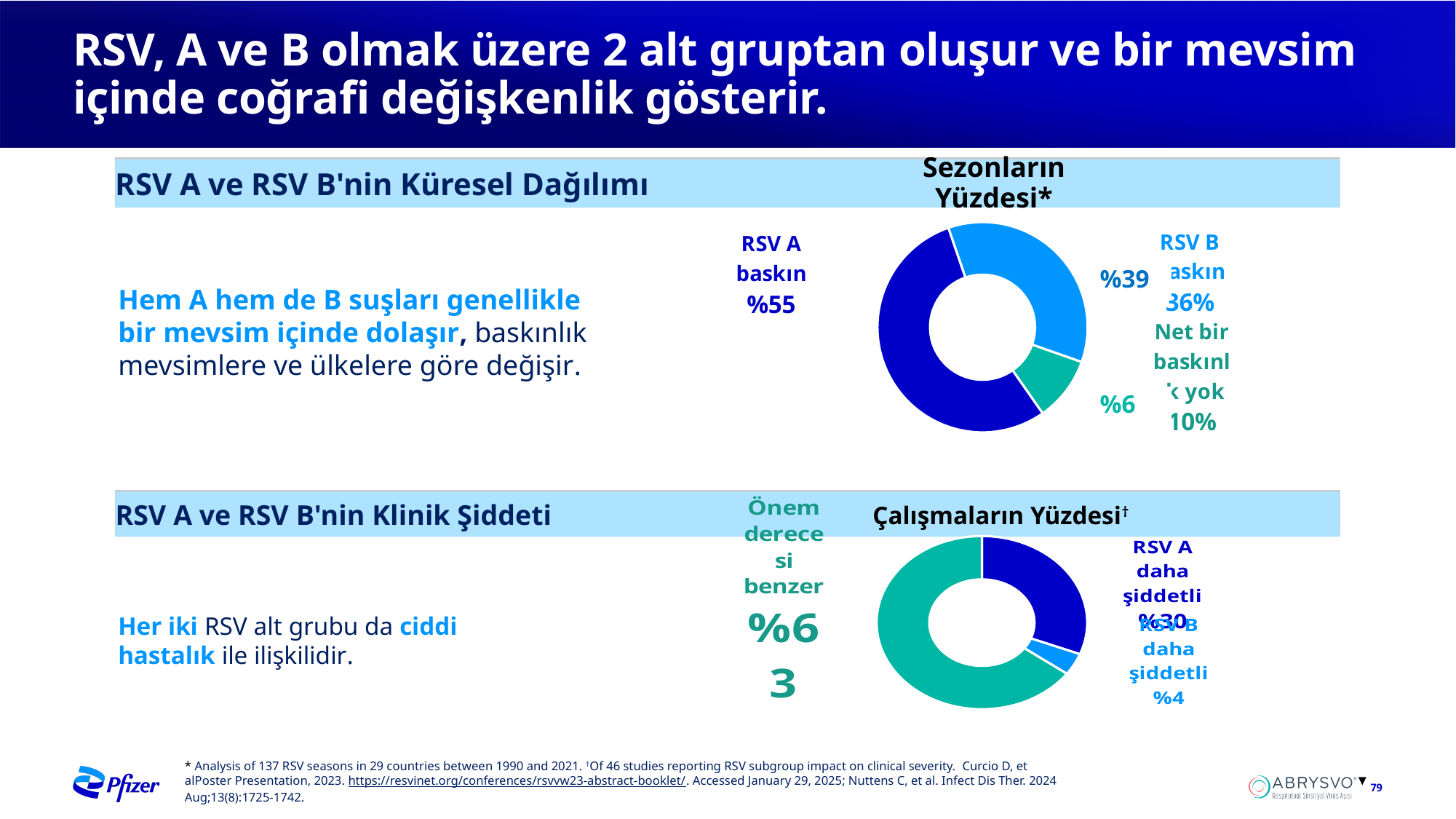
In the 'Sezonların Yüzdesi*' donut chart, which category has the largest share? RSV A baskın What type of chart is used for 'Sezonların Yüzdesi*'? Donut (pie) chart In the 'Çalışmaların Yüzdesi†' donut chart, what percentage of studies found severity to be similar ('Önem derecesi benzer')? %63 In the 'Çalışmaların Yüzdesi†' donut chart, what percentage of studies found RSV B more severe ('RSV B daha şiddetli')? %4 In the 'Çalışmaların Yüzdesi†' donut chart, what percentage of studies found RSV A more severe ('RSV A daha şiddetli')? %30 In the 'Çalışmaların Yüzdesi†' donut chart, what is the difference between the 'RSV A daha şiddetli' and 'RSV B daha şiddetli' percentages? 26 percentage points In the 'Çalışmaların Yüzdesi†' donut chart, which category has the smallest share? RSV B daha şiddetli In the 'Sezonların Yüzdesi*' donut chart, how many slices are there? 3 In the 'Sezonların Yüzdesi*' donut chart, which category has the smallest share? Net bir baskınlık yok In the 'Çalışmaların Yüzdesi†' donut chart, which is larger: 'Önem derecesi benzer' or 'RSV A daha şiddetli'? Önem derecesi benzer In the 'Sezonların Yüzdesi*' donut chart, what percentage of seasons is labelled 'RSV A baskın'? %55